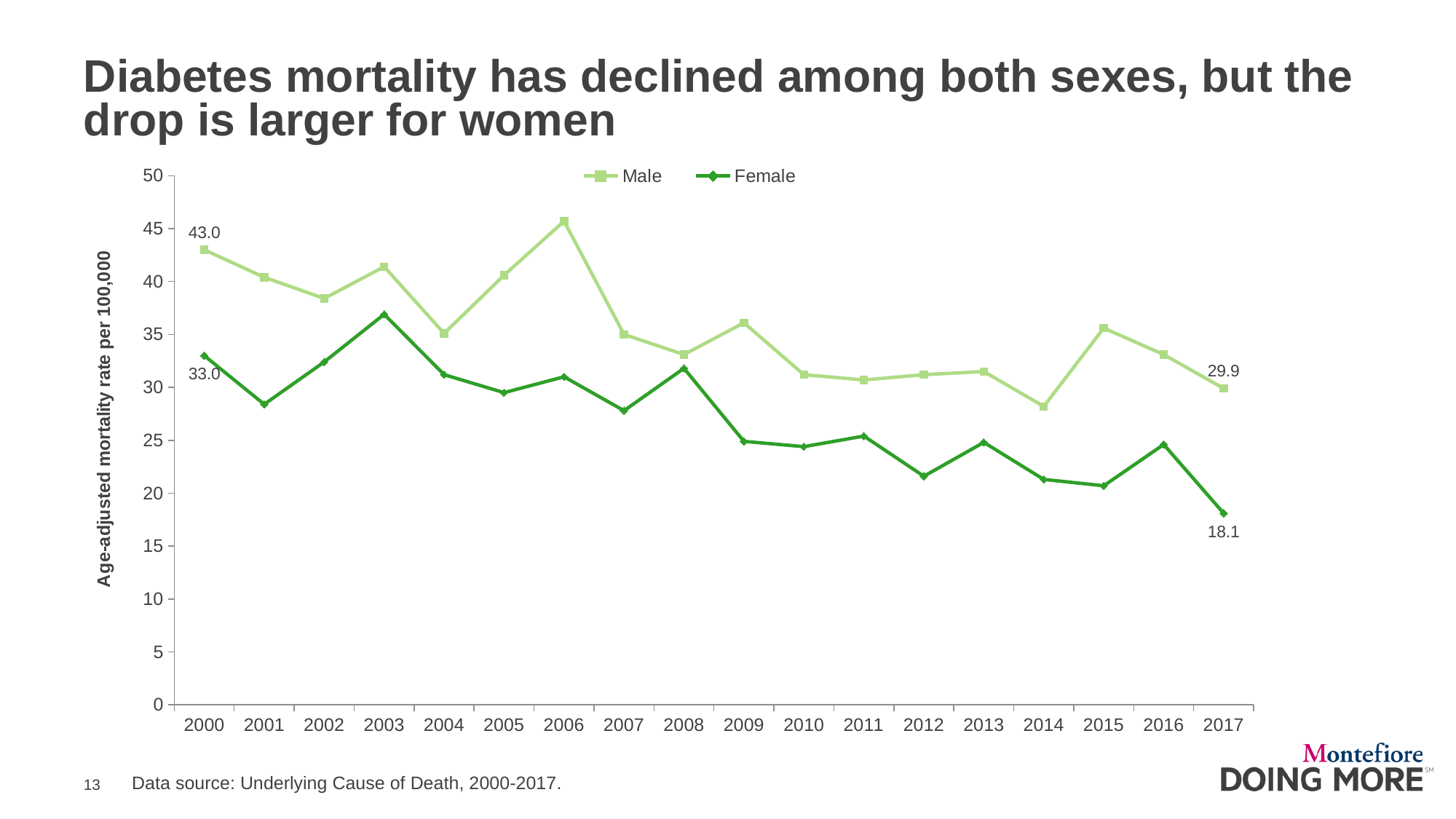
How many series does the legend list? 2 How many years are shown on the x axis? 18 By how much did the male mortality rate fall from 2000 to 2017? 13.1 Is the female mortality rate in 2014 greater or less than 25? less What kind of chart is shown on the slide? Line chart What is the male mortality rate in 2017? 29.9 In 2017, what is the difference between the male and female mortality rates? 11.8 In which year does the Male series reach its highest value? 2006 In which year does the Female series reach its lowest value? 2017 What is the male age-adjusted diabetes mortality rate in 2000? 43.0 By how much did the female mortality rate fall from 2000 to 2017? 14.9 What is the female age-adjusted diabetes mortality rate in 2017? 18.1